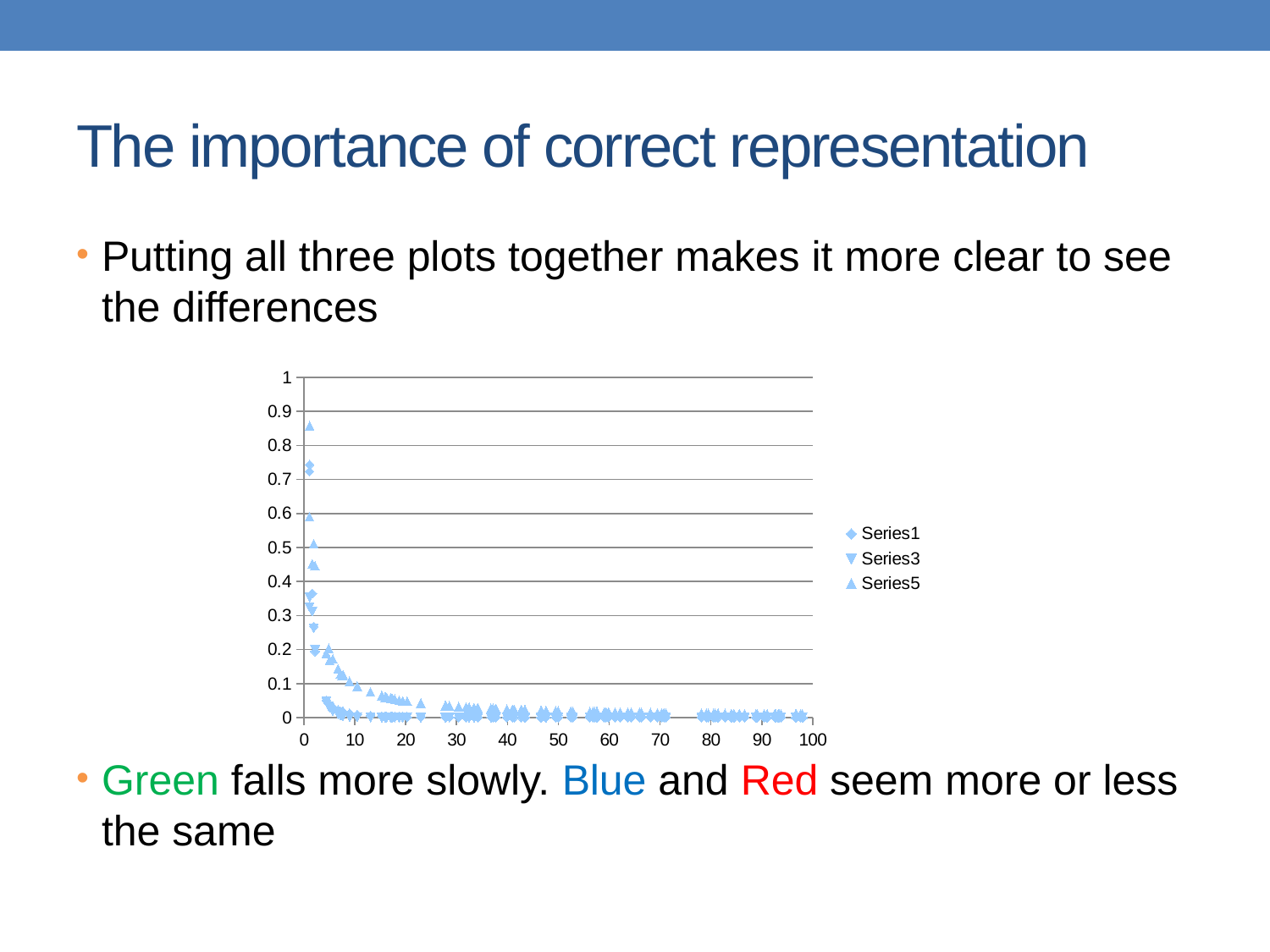
How many series does the chart's legend list? 3 What are the names of the series listed in the chart's legend? Series1, Series3, Series5 Which series reaches the highest value on the chart? Series5 Is the highest value for Series5 greater or less than 0.8? greater Which series has the larger maximum value, Series5 or Series3? Series5 What is the highest tick value shown on the chart's y axis? 1 Are the values for Series5 at x = 90 greater or less than 0.1? less What kind of chart is shown on the slide? Scatter chart Do the plotted values rise or fall as the x axis increases? fall Is the highest value for Series1 greater or less than 0.5? greater